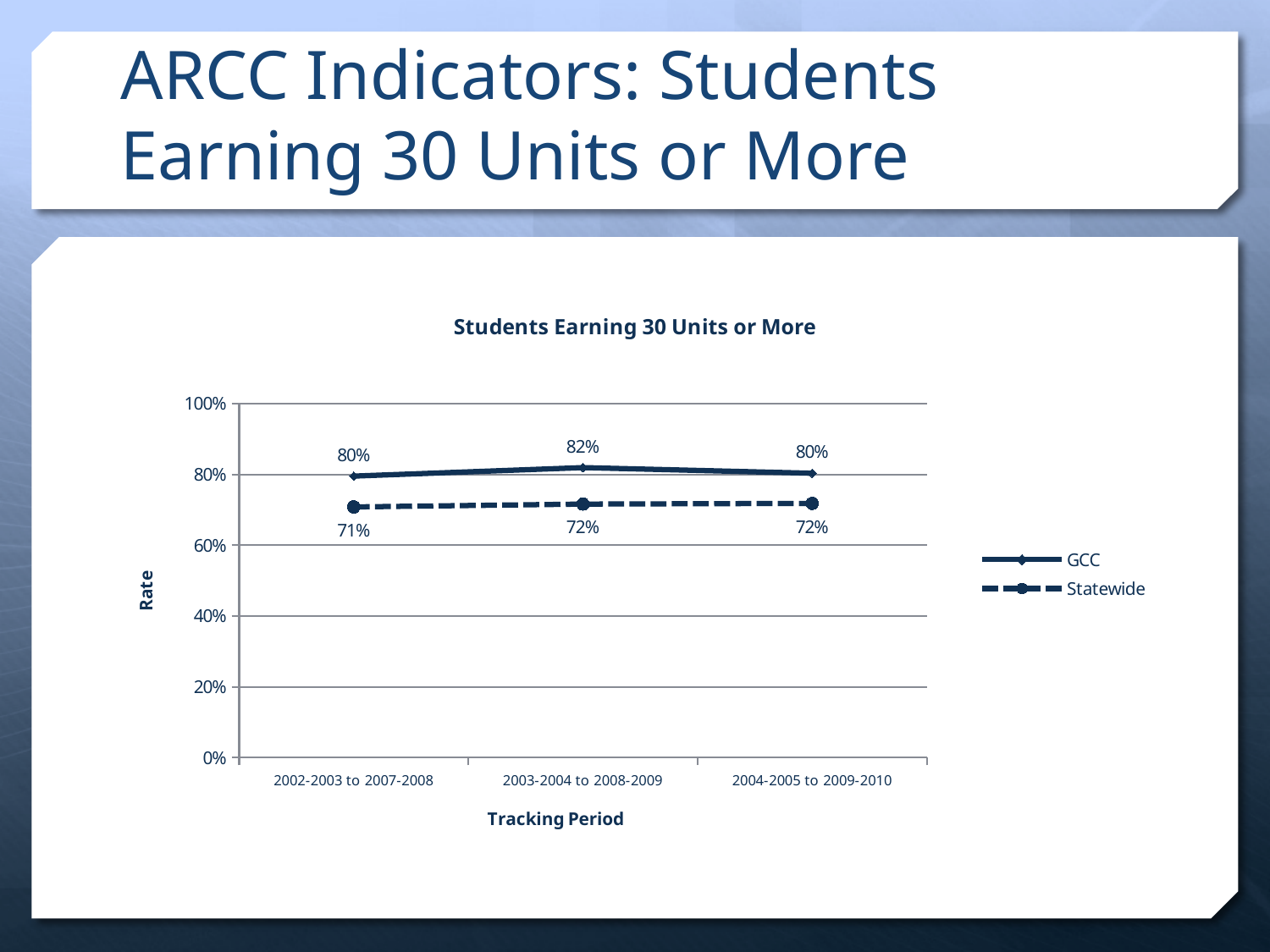
What is the GCC rate for the 2004-2005 to 2009-2010 tracking period? 80% How many tracking periods are shown on the x axis? 3 Which series has the higher rate in the 2004-2005 to 2009-2010 tracking period, GCC or Statewide? GCC In which tracking period is the Statewide rate lowest? 2002-2003 to 2007-2008 In which tracking period is the GCC rate highest? 2003-2004 to 2008-2009 How many series does the legend list? 2 What is the GCC rate for the 2003-2004 to 2008-2009 tracking period? 82% What is the Statewide rate for the 2002-2003 to 2007-2008 tracking period? 71% What kind of chart is shown on the slide? line chart Is the Statewide rate for 2004-2005 to 2009-2010 greater or less than 80%? less What is the difference between the GCC and Statewide rates for the 2003-2004 to 2008-2009 tracking period? 10% What is the title of the chart? Students Earning 30 Units or More